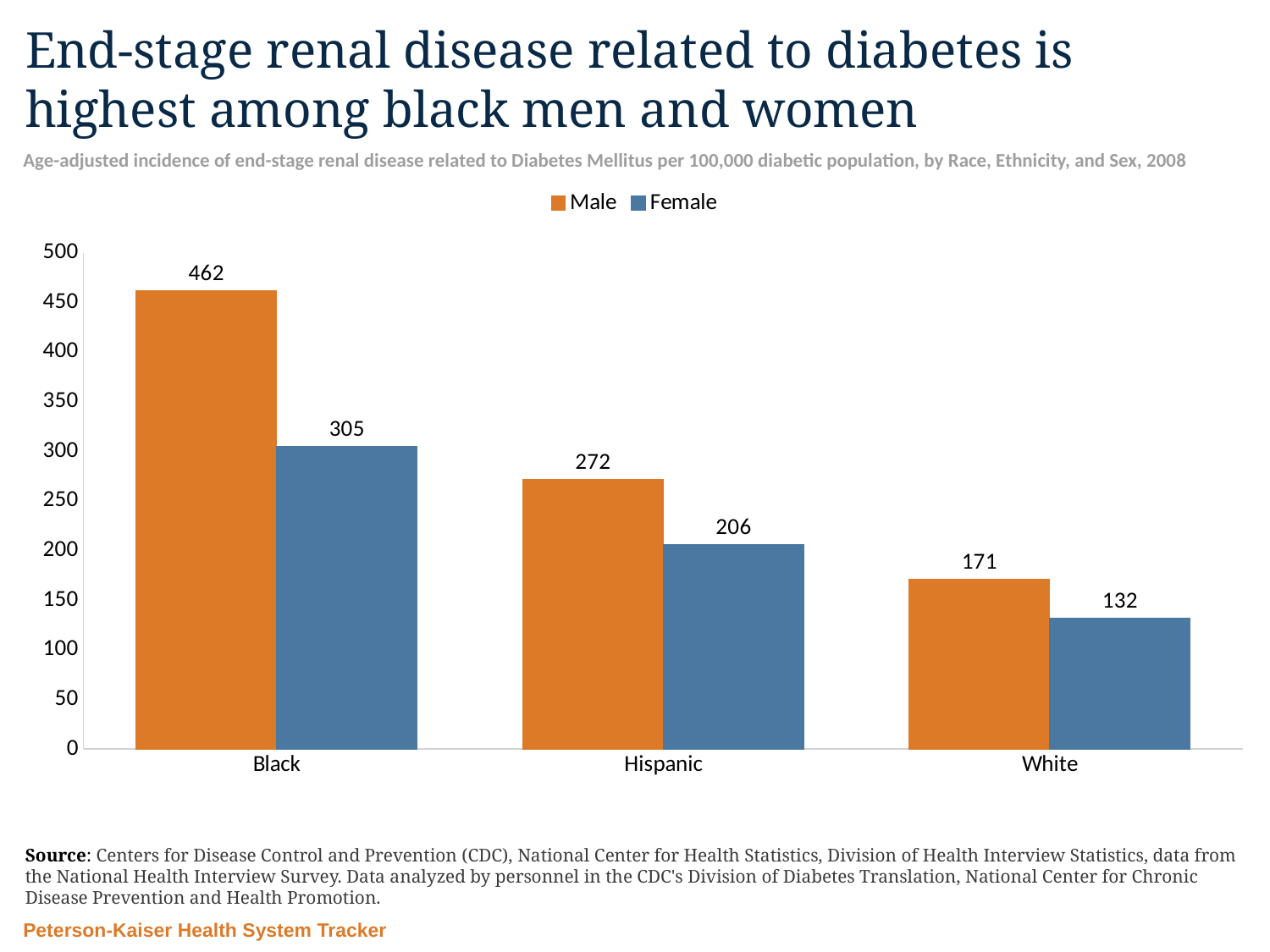
How many categories are shown on the x axis? 3 What is the value for Female in the Hispanic category? 206 How many series does the legend list? 2 What kind of chart is shown on the slide? Bar chart Is the Male value for White greater or less than 200? less Which category has the highest Male value? Black What is the value for Male in the Black category? 462 Which category has the lowest Female value? White What is the difference between the Male and Female values for the Black category? 157 What is the difference between the Male values for Hispanic and White? 101 Which is larger, the Female value for Black or the Male value for Hispanic? Female value for Black What is the value for Female in the White category? 132